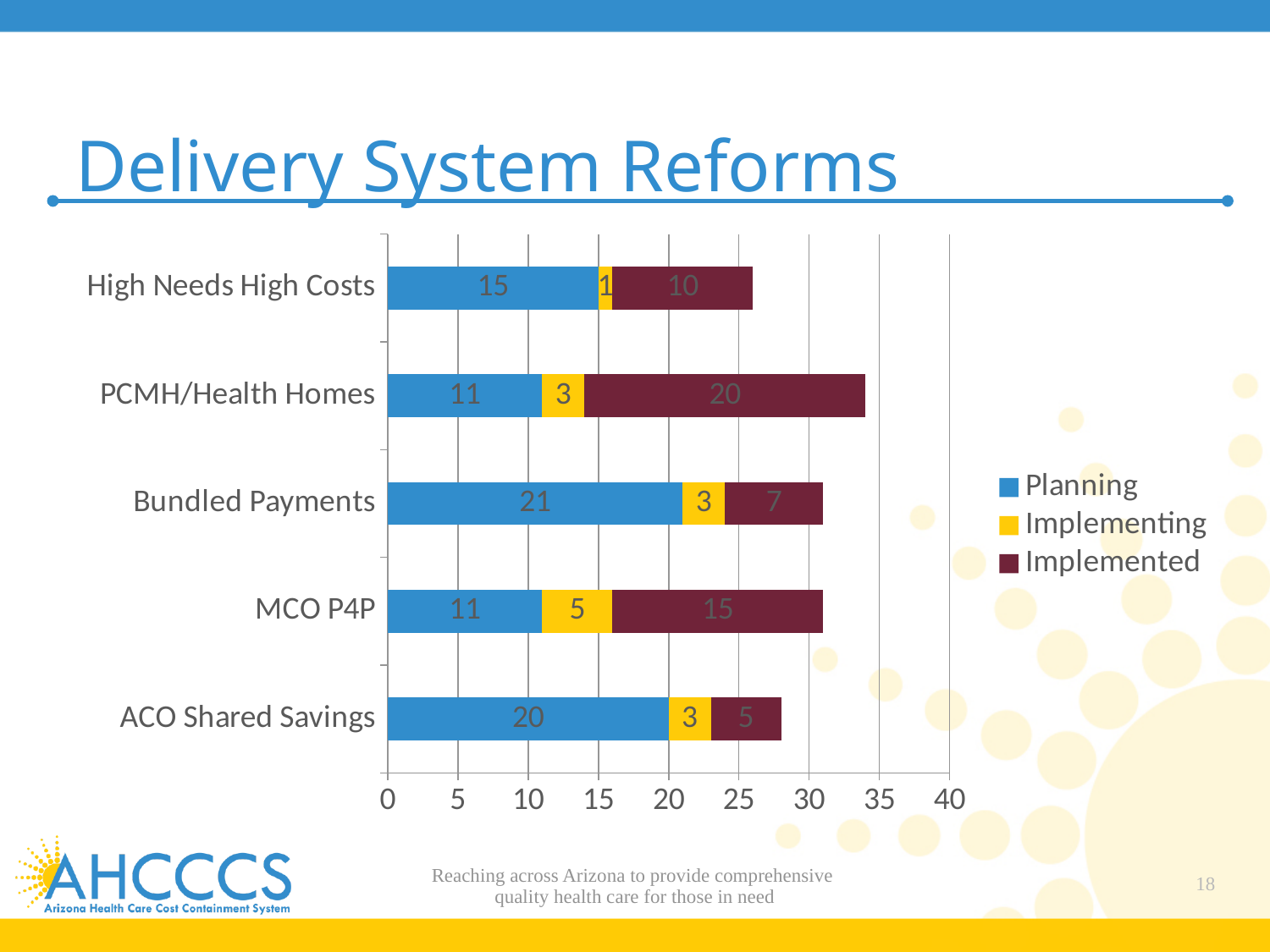
Which series is shown in yellow in the legend? Implementing Which category has the lowest Implementing value? High Needs High Costs Which category has the highest Implemented value? PCMH/Health Homes What is the Planning value for Bundled Payments? 21 What is the Implementing value for MCO P4P? 5 What kind of chart is shown on the slide? Stacked bar chart What is the difference between the Planning values for Bundled Payments and MCO P4P? 10 What is the total of the stacked bar for PCMH/Health Homes? 34 How many series does the legend list? 3 What is the Implemented value for PCMH/Health Homes? 20 Which is larger, the Implemented value for MCO P4P or the Implemented value for ACO Shared Savings? MCO P4P How many categories are shown on the chart? 5